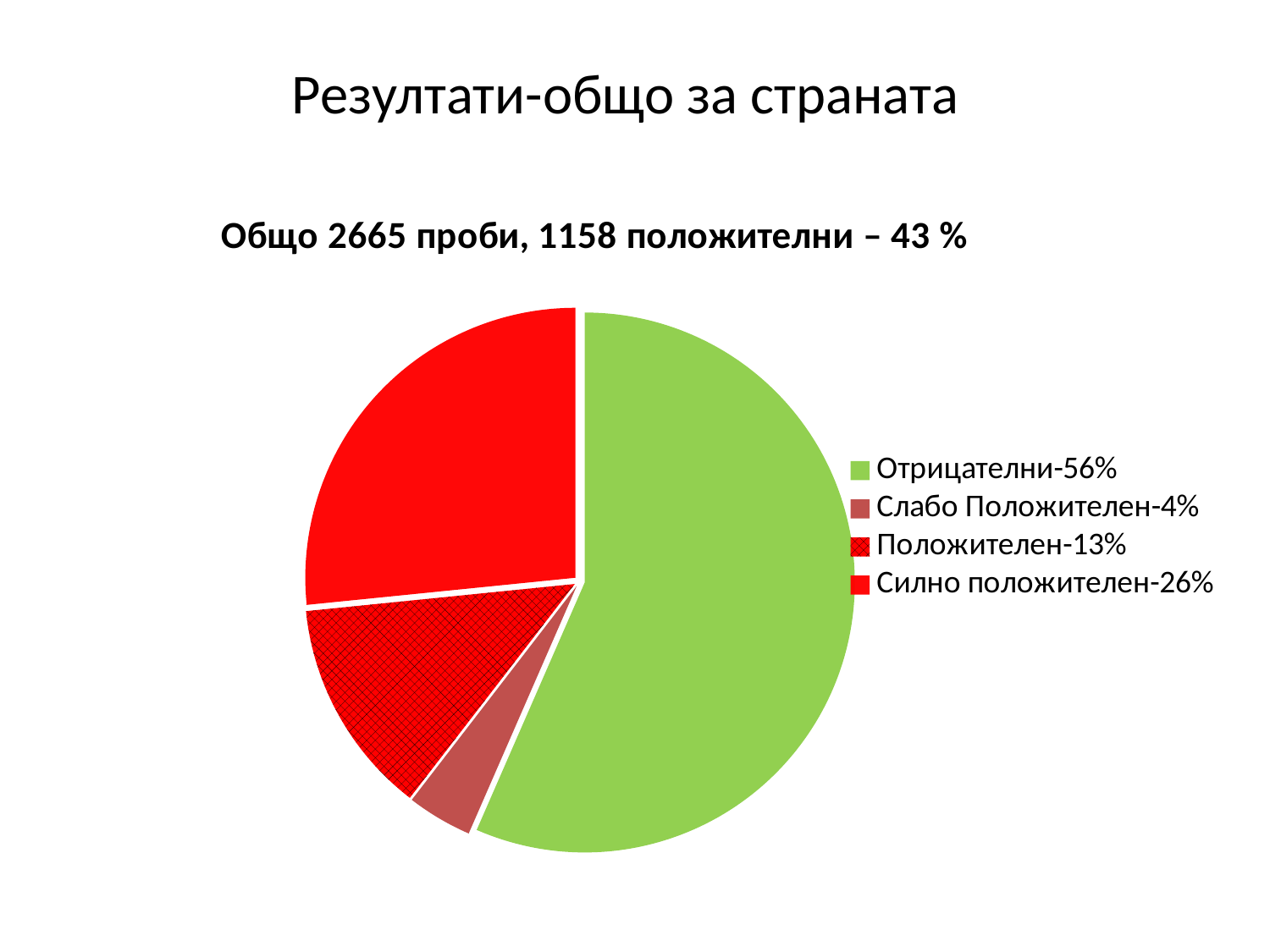
What is the title shown directly above the pie chart? Общо 2665 проби, 1158 положителни – 43 % What is the difference in percentage points between the "Положителен" slice and the "Слабо Положителен" slice? 9 What percentage is shown for "Слабо Положителен" in the legend? 4% What kind of chart is shown on the slide? Pie chart What percentage is shown for "Положителен" in the legend? 13% What share of the pie does the slice "Силно положителен" represent? 26% What share of the pie does the slice "Отрицателни" represent? 56% How many slices does the pie chart have? 4 Which slice of the pie chart is the smallest? Слабо Положителен What is the difference in percentage points between the "Отрицателни" slice and the "Силно положителен" slice? 30 Which is larger, the "Силно положителен" slice or the "Положителен" slice? Силно положителен Which slice of the pie chart is the largest? Отрицателни